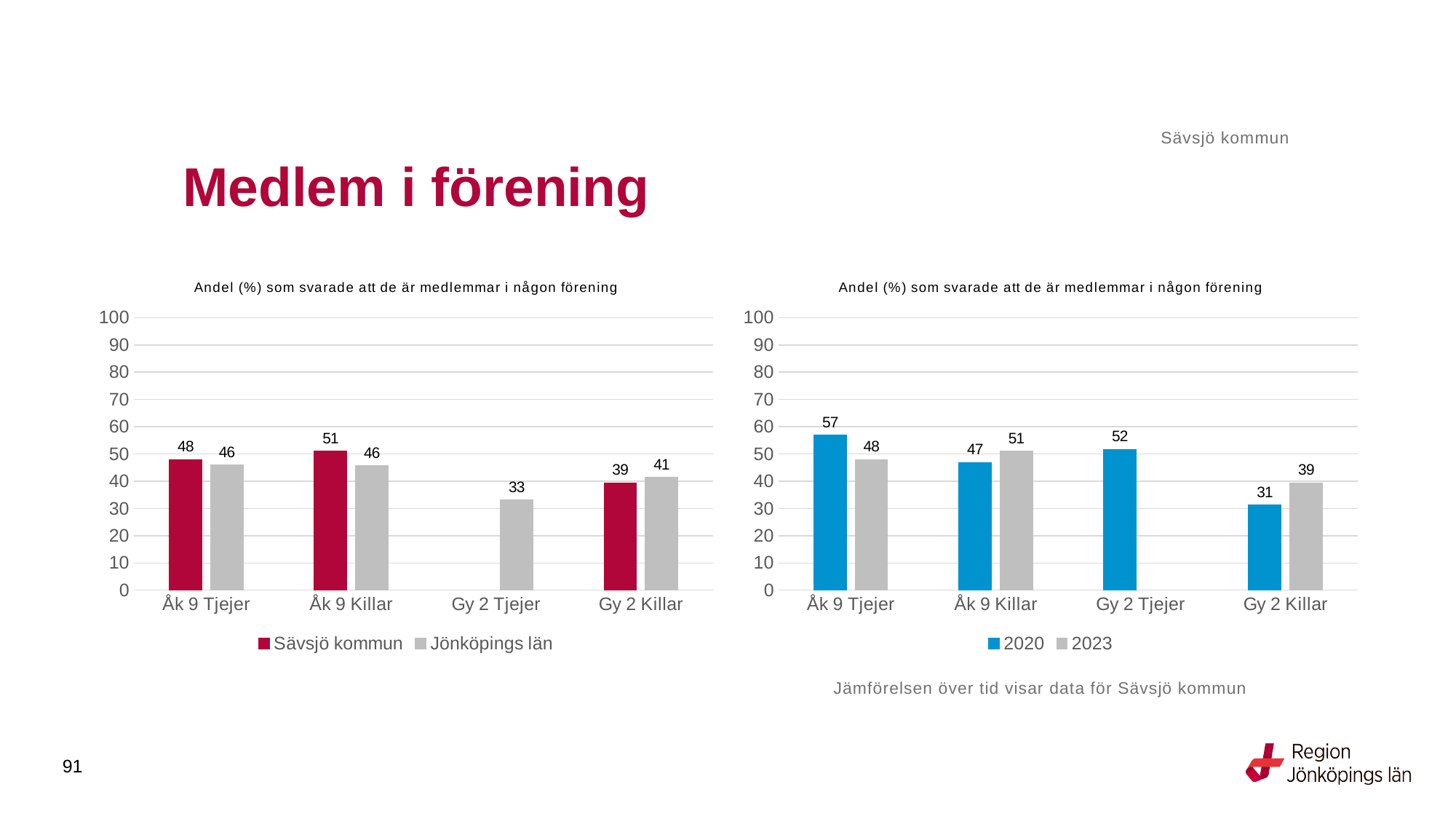
In the left chart, what is the value for Sävsjö kommun for Åk 9 Killar? 51 In the right chart, which category has the highest value for 2020? Åk 9 Tjejer In the right chart, what is the value for 2020 for Gy 2 Tjejer? 52 In the left chart, which is larger for Gy 2 Killar: Sävsjö kommun or Jönköpings län? Jönköpings län In the left chart, which category has the lowest value for Jönköpings län? Gy 2 Tjejer What kind of chart is the left chart? Bar chart In the right chart, what is the difference between 2020 and 2023 for Åk 9 Tjejer? 9 In the right chart, what is the value for 2023 for Gy 2 Killar? 39 In the left chart, what is the difference between Sävsjö kommun and Jönköpings län for Åk 9 Killar? 5 In the left chart, what is the value for Jönköpings län for Gy 2 Tjejer? 33 How many categories are shown on the x axis of the right chart? 4 In the right chart, how many series does the legend list? 2